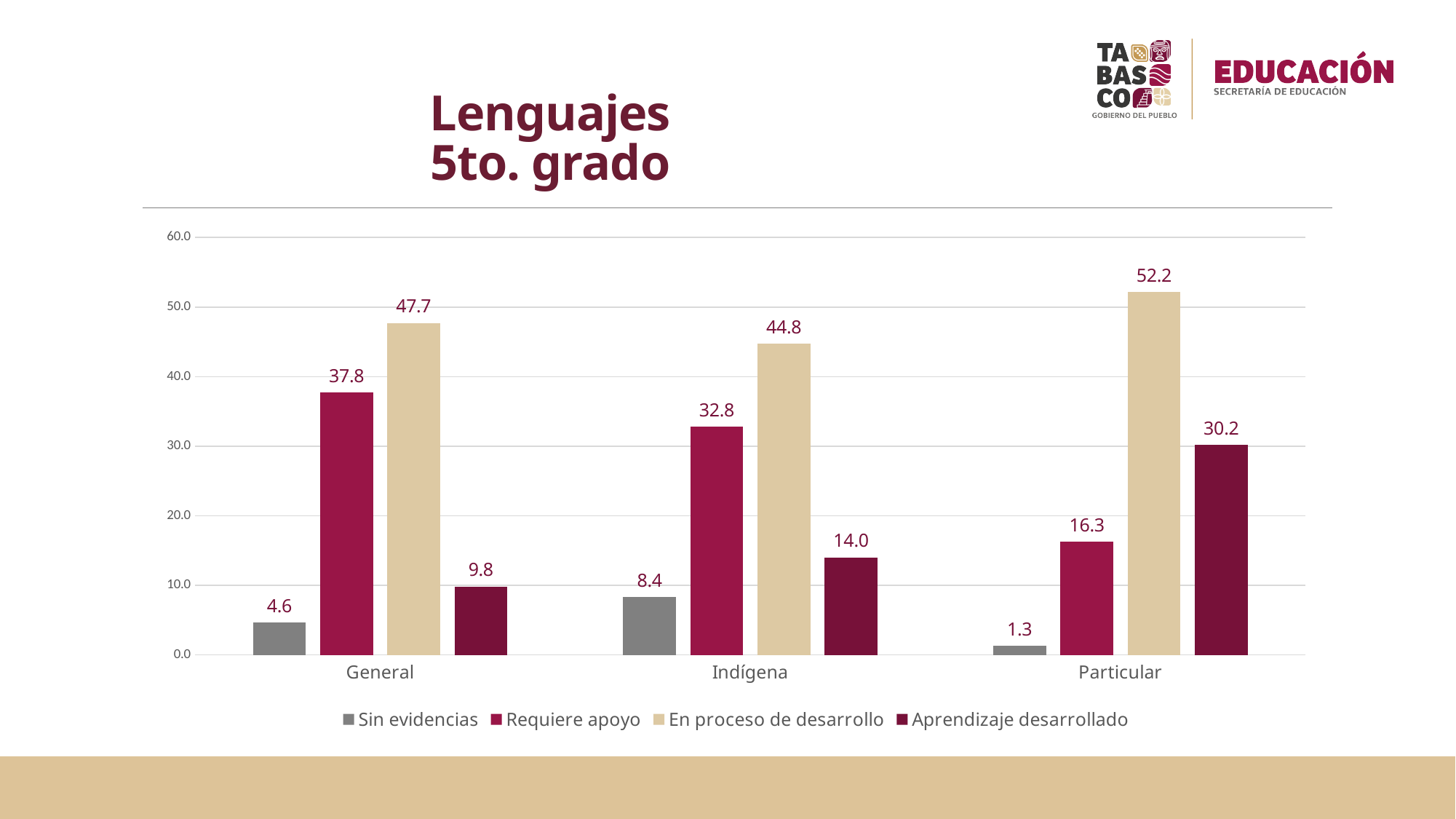
How many series does the legend list? 4 Which category has the highest value for "En proceso de desarrollo"? Particular What is the value for "Aprendizaje desarrollado" in the Indígena category? 14.0 What is the difference between "Requiere apoyo" in General and "Requiere apoyo" in Particular? 21.5 What is the title of the slide? Lenguajes 5to. grado Which is larger: "Aprendizaje desarrollado" in Particular or "Requiere apoyo" in Particular? Aprendizaje desarrollado in Particular What is the value for "Sin evidencias" in the Particular category? 1.3 How many categories are shown on the x axis? 3 What kind of chart is shown on the slide? Bar chart Which category has the lowest value for "Sin evidencias"? Particular Is the value for "Requiere apoyo" in Indígena greater or less than 30.0? greater What is the value for "En proceso de desarrollo" in the General category? 47.7